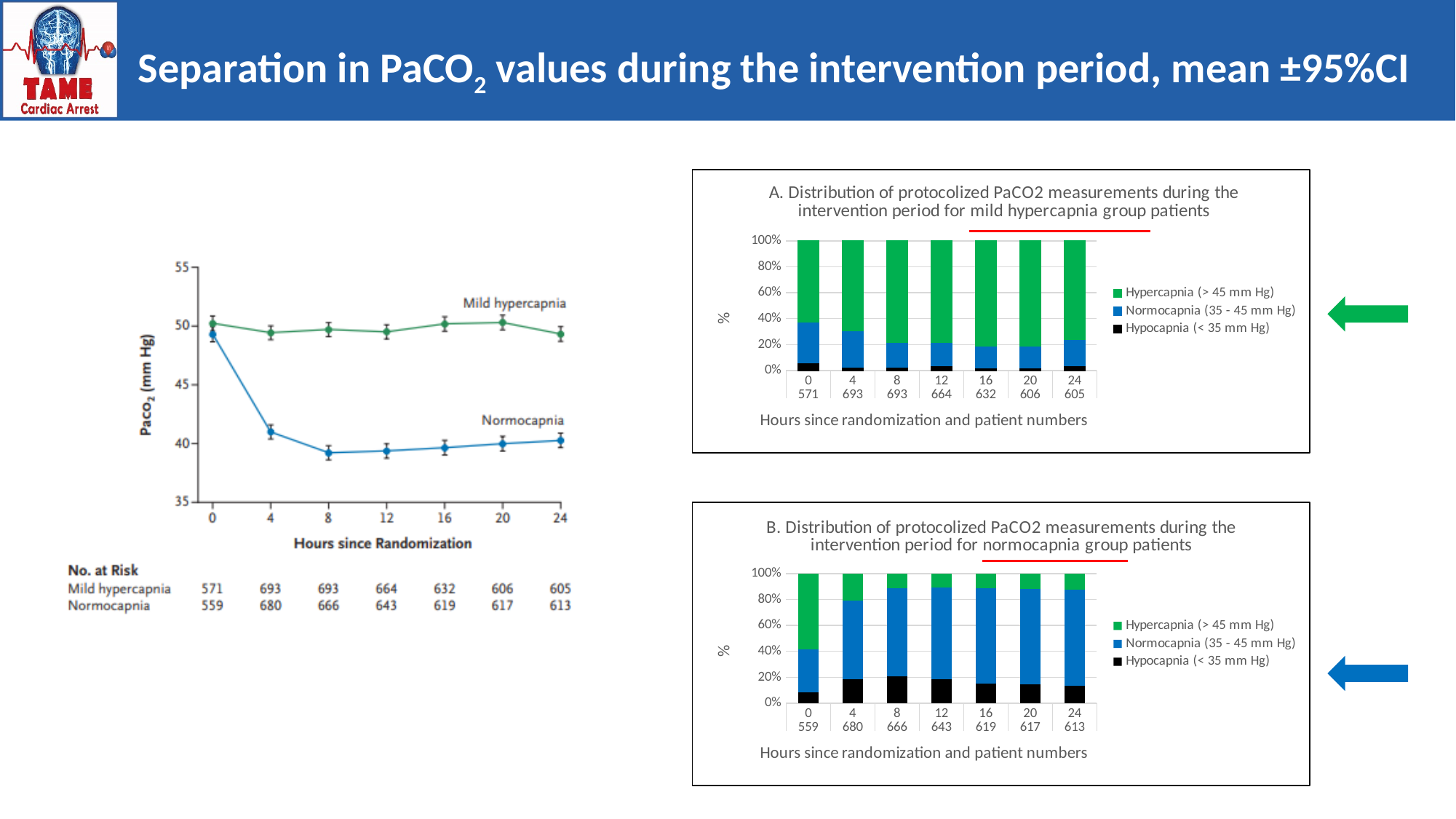
In the left line chart, is the Normocapnia value at 8 hours greater or less than 45 mm Hg? less In chart B (normocapnia group patients), which category makes up the largest share of the bar at 12 hours? Normocapnia (35 - 45 mm Hg) How many time points are shown on the x axis of chart A (mild hypercapnia group patients)? 7 In the left line chart, does the Normocapnia line rise or fall between 0 and 8 hours? fall What kind of chart is chart A (Distribution of protocolized PaCO2 measurements for mild hypercapnia group patients)? bar chart In chart A (mild hypercapnia group patients), what is the patient number shown under the 0 hours bar? 571 In the left line chart, is the Mild hypercapnia value at 8 hours greater or less than 45 mm Hg? greater What kind of chart is the chart on the left of the slide (PaCO2 vs Hours since Randomization)? line chart In the left line chart, which series has the higher PaCO2 value at 4 hours, Mild hypercapnia or Normocapnia? Mild hypercapnia How many series does the legend of chart B (normocapnia group patients) list? 3 In chart A (mild hypercapnia group patients), is the Hypercapnia (> 45 mm Hg) share at 16 hours greater or less than 60%? greater In the left line chart's No. at Risk table, how many Normocapnia patients were at risk at 12 hours? 643